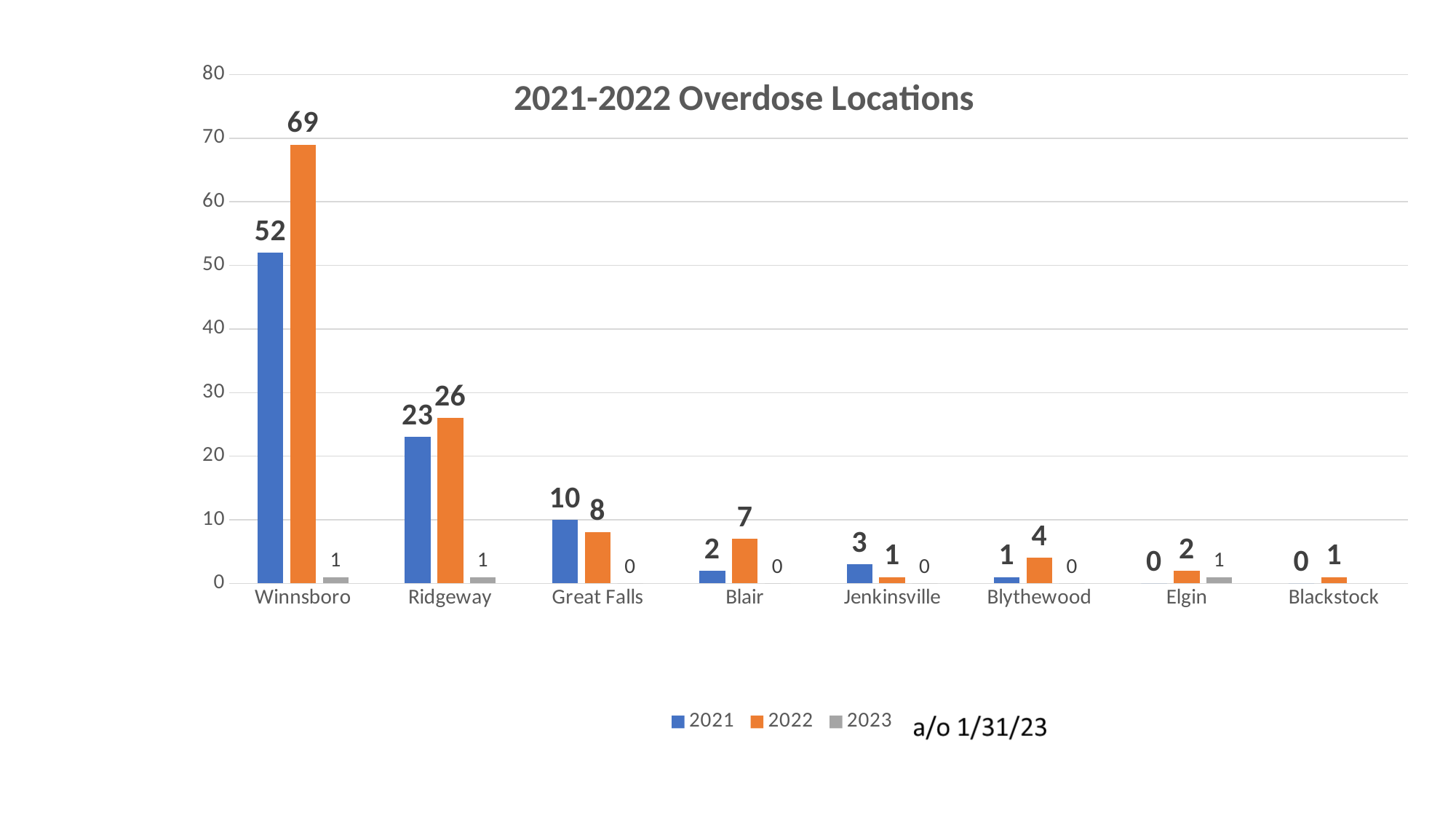
What is the total of the 2021, 2022 and 2023 values for Ridgeway? 50 Which is larger for Great Falls, the 2021 value or the 2022 value? 2021 What is the 2023 value for Elgin? 1 What is the difference between the 2022 and 2021 values for Winnsboro? 17 What is the 2022 value for Winnsboro? 69 Which location has the highest 2021 value? Winnsboro Which location has the lowest 2022 value? Jenkinsville and Blackstock (1 each) What kind of chart is this? Bar chart How many locations are shown on the x axis? 8 What is the title of the chart? 2021-2022 Overdose Locations How many series does the legend list? 3 What is the 2021 value for Ridgeway? 23